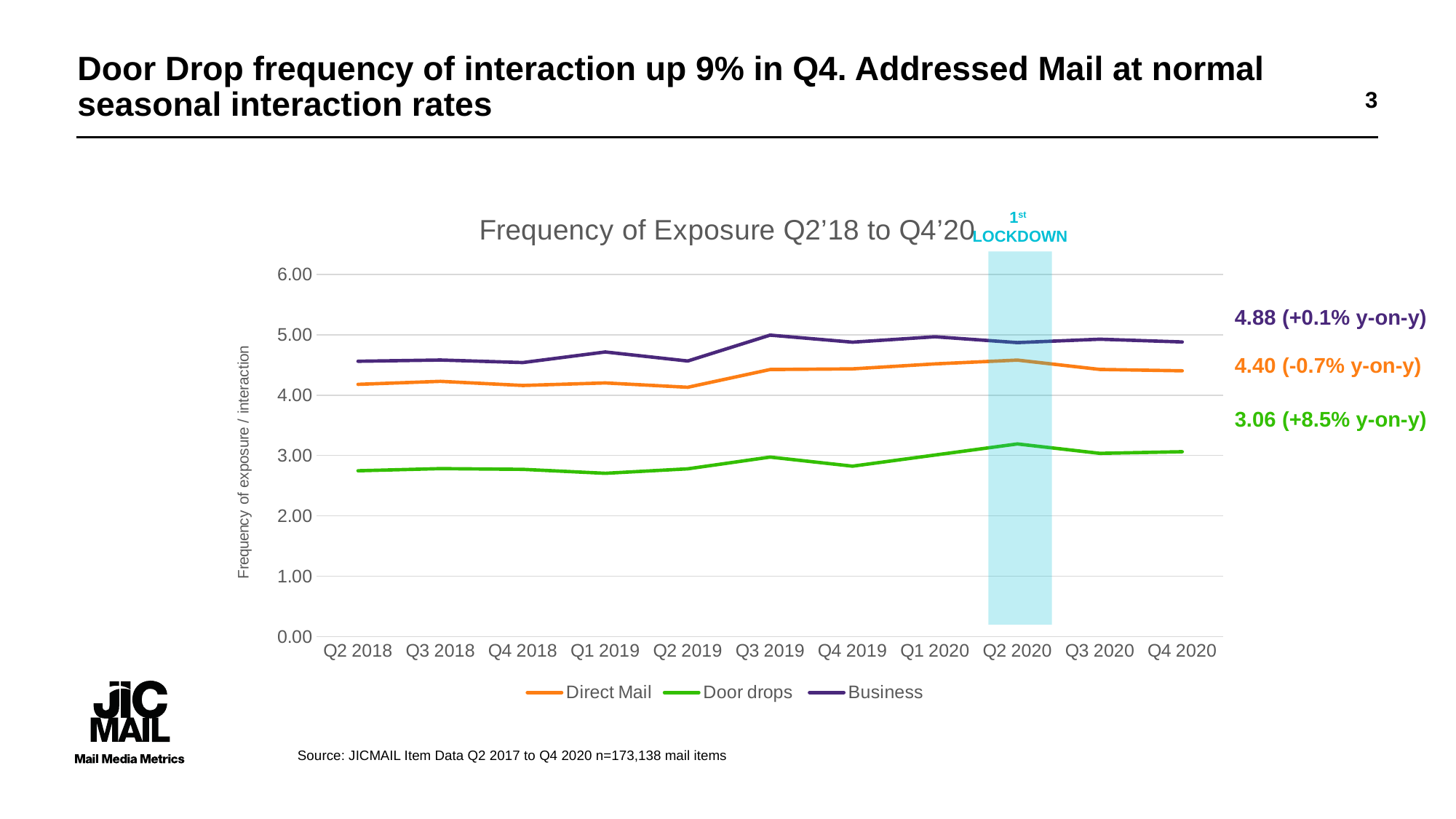
How many quarters are plotted along the x axis? 11 Which series has the highest values across the chart? Business How many series does the legend list? 3 Do the Door drops values rise or fall from Q2 2018 to Q4 2020? Rise What is the difference between the Business and Door drops values in Q4 2020? 1.82 Which series has the lowest values across the chart? Door drops What is the Direct Mail value for Q4 2020? 4.40 What type of chart is shown on the slide? Line chart What is the Business value for Q4 2020? 4.88 Which quarter is highlighted as the 1st lockdown? Q2 2020 What is the Door drops value for Q4 2020? 3.06 Is the Door drops value for Q2 2018 greater or less than 3.00? less